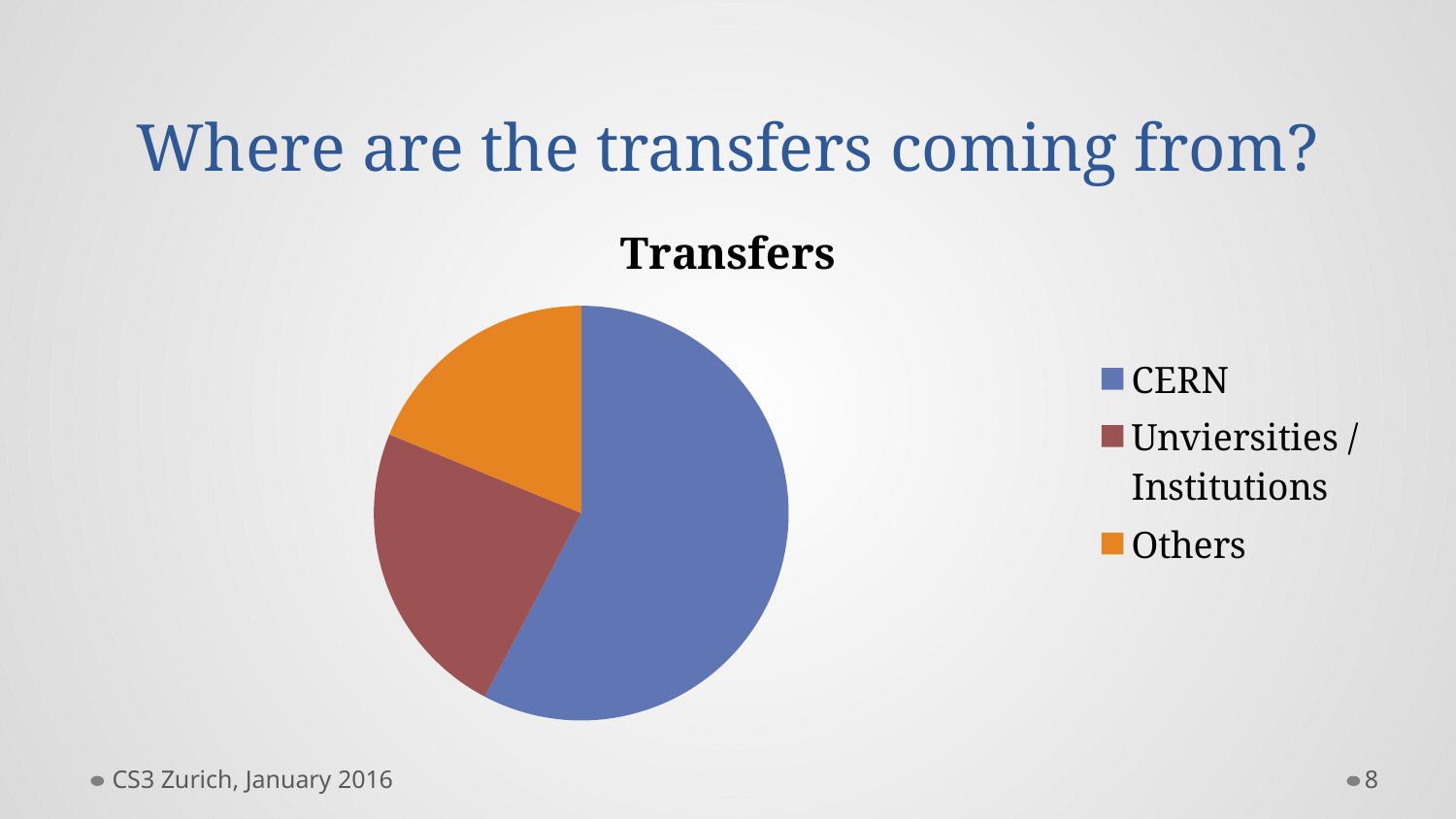
Which category is shown in blue? CERN How many entries does the legend list? 3 Does the CERN slice account for more or less than half of the pie? more Which is larger, the slice for CERN or the slice for Others? CERN How many slices does the pie chart have? 3 Which is larger, the slice for CERN or the slice for Unviersities / Institutions? CERN What is the title of the chart? Transfers What kind of chart is shown on the slide? Pie chart What colour is the slice for Others? Orange Which category has the largest slice of the pie? CERN